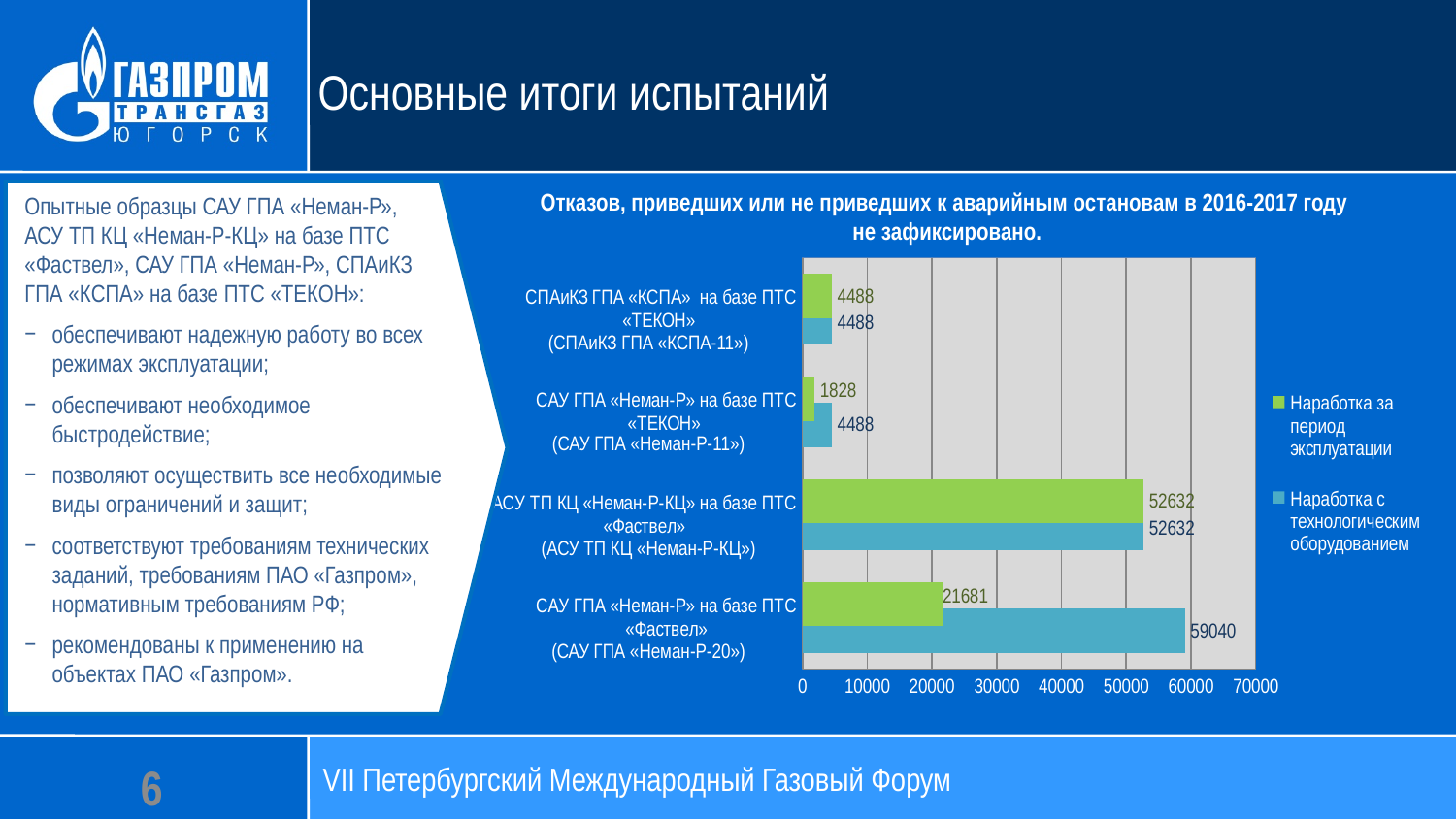
What type of chart is shown on the slide? bar chart What is the value of «Наработка с технологическим оборудованием» for АСУ ТП КЦ «Неман-Р-КЦ» на базе ПТС «Фаствел»? 52632 How many series does the chart legend list? 2 Which is larger: «Наработка за период эксплуатации» for АСУ ТП КЦ «Неман-Р-КЦ» на базе ПТС «Фаствел» or for СПАиКЗ ГПА «КСПА» на базе ПТС «ТЕКОН»? АСУ ТП КЦ «Неман-Р-КЦ» на базе ПТС «Фаствел» Which category has the highest value of «Наработка с технологическим оборудованием»? САУ ГПА «Неман-Р» на базе ПТС «Фаствел» (САУ ГПА «Неман-Р-20») Which colour represents the series «Наработка за период эксплуатации» in the chart? green What is the value of «Наработка за период эксплуатации» for САУ ГПА «Неман-Р» на базе ПТС «ТЕКОН» (САУ ГПА «Неман-Р-11»)? 1828 What is the value of «Наработка с технологическим оборудованием» for САУ ГПА «Неман-Р» на базе ПТС «Фаствел» (САУ ГПА «Неман-Р-20»)? 59040 What is the value of «Наработка за период эксплуатации» for САУ ГПА «Неман-Р» на базе ПТС «Фаствел» (САУ ГПА «Неман-Р-20»)? 21681 How many categories (systems) are plotted on the chart? 4 What is the difference between «Наработка с технологическим оборудованием» and «Наработка за период эксплуатации» for САУ ГПА «Неман-Р» на базе ПТС «Фаствел» (САУ ГПА «Неман-Р-20»)? 37359 Which category has the lowest value of «Наработка за период эксплуатации»? САУ ГПА «Неман-Р» на базе ПТС «ТЕКОН» (САУ ГПА «Неман-Р-11»)